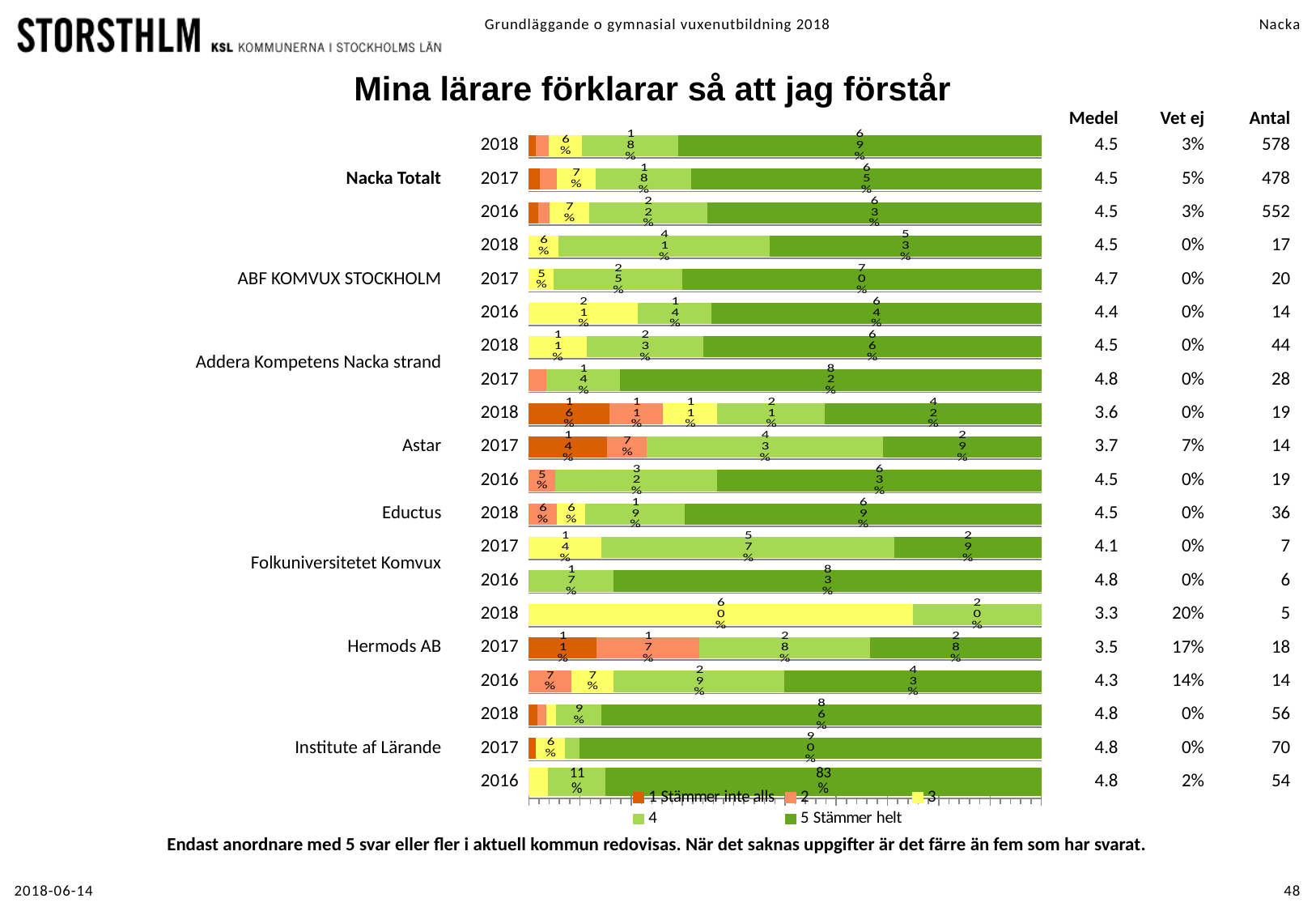
What kind of chart is shown on the slide? Stacked bar chart Which bar has the highest '5 Stämmer helt' share in the chart? Institute af Lärande 2017 What is the legend label for the darkest green series? 5 Stämmer helt What share of Nacka Totalt respondents in 2018 answered '5 Stämmer helt'? 69% What share of Institute af Lärande respondents in 2017 answered '5 Stämmer helt'? 90% What share of Hermods AB respondents in 2018 answered '3'? 60% What share of Astar respondents in 2018 answered '1 Stämmer inte alls'? 16% Does the '5 Stämmer helt' share for Nacka Totalt rise or fall from 2016 to 2018? Rises Which is larger: the '5 Stämmer helt' share for Addera Kompetens Nacka strand in 2017 or in 2018? 2017 By how many percentage points did the '5 Stämmer helt' share for Nacka Totalt change from 2017 to 2018? 4 percentage points What share of ABF KOMVUX STOCKHOLM respondents in 2017 answered '5 Stämmer helt'? 70% How many series does the chart legend list? 5